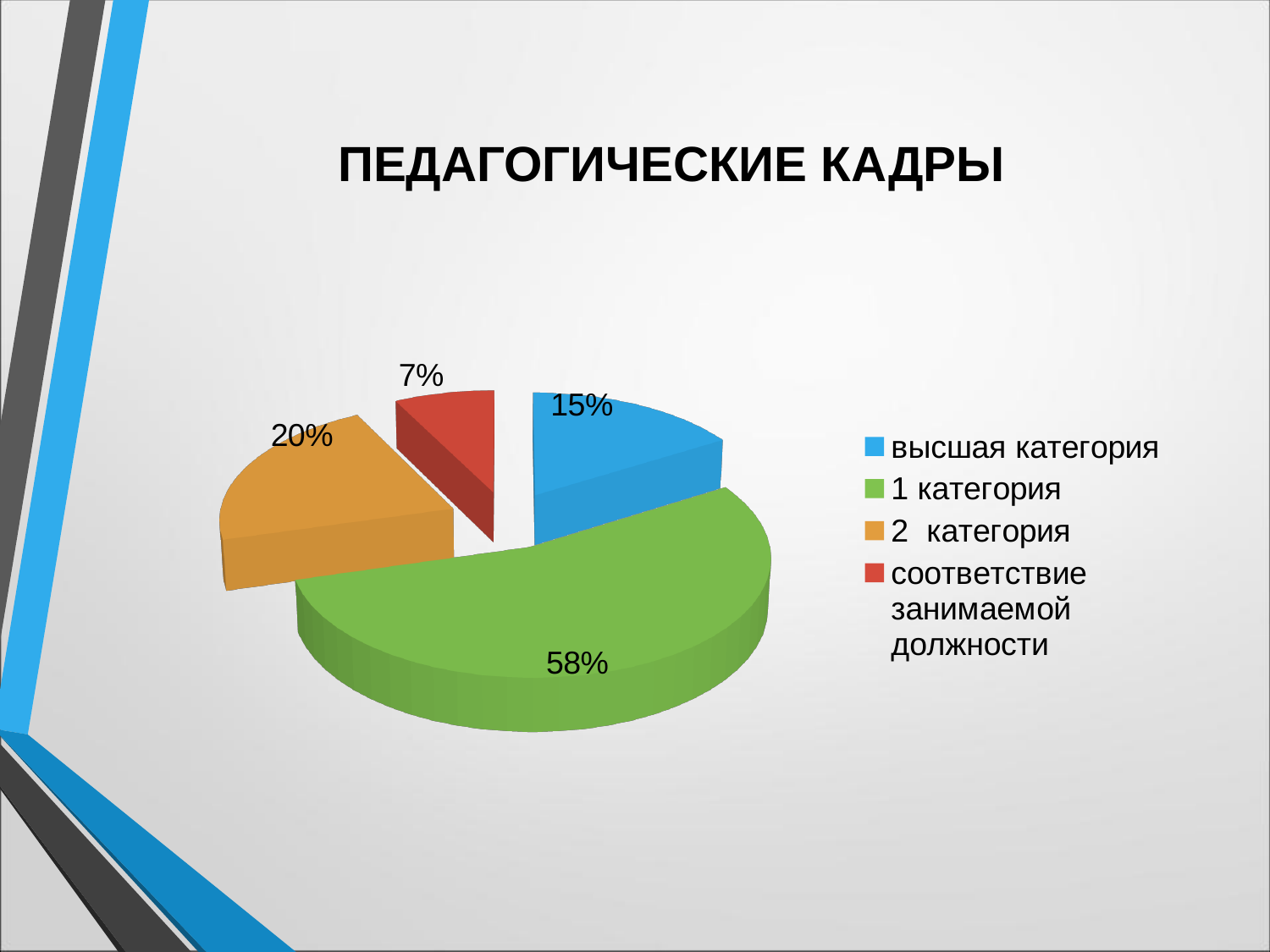
What kind of chart is shown on the slide? pie chart Which category has the smallest slice of the pie? соответствие занимаемой должности What colour is the slice for "1 категория"? green What share of the pie does "1 категория" have? 58% Which is larger: the share for "высшая категория" or the share for "2 категория"? 2 категория What share of the pie does "высшая категория" have? 15% What share of the pie does "соответствие занимаемой должности" have? 7% Which category has the largest slice of the pie? 1 категория What is the difference in percentage points between "2 категория" and "высшая категория"? 5% How many categories does the pie chart have? 4 What is the title of the slide? ПЕДАГОГИЧЕСКИЕ КАДРЫ